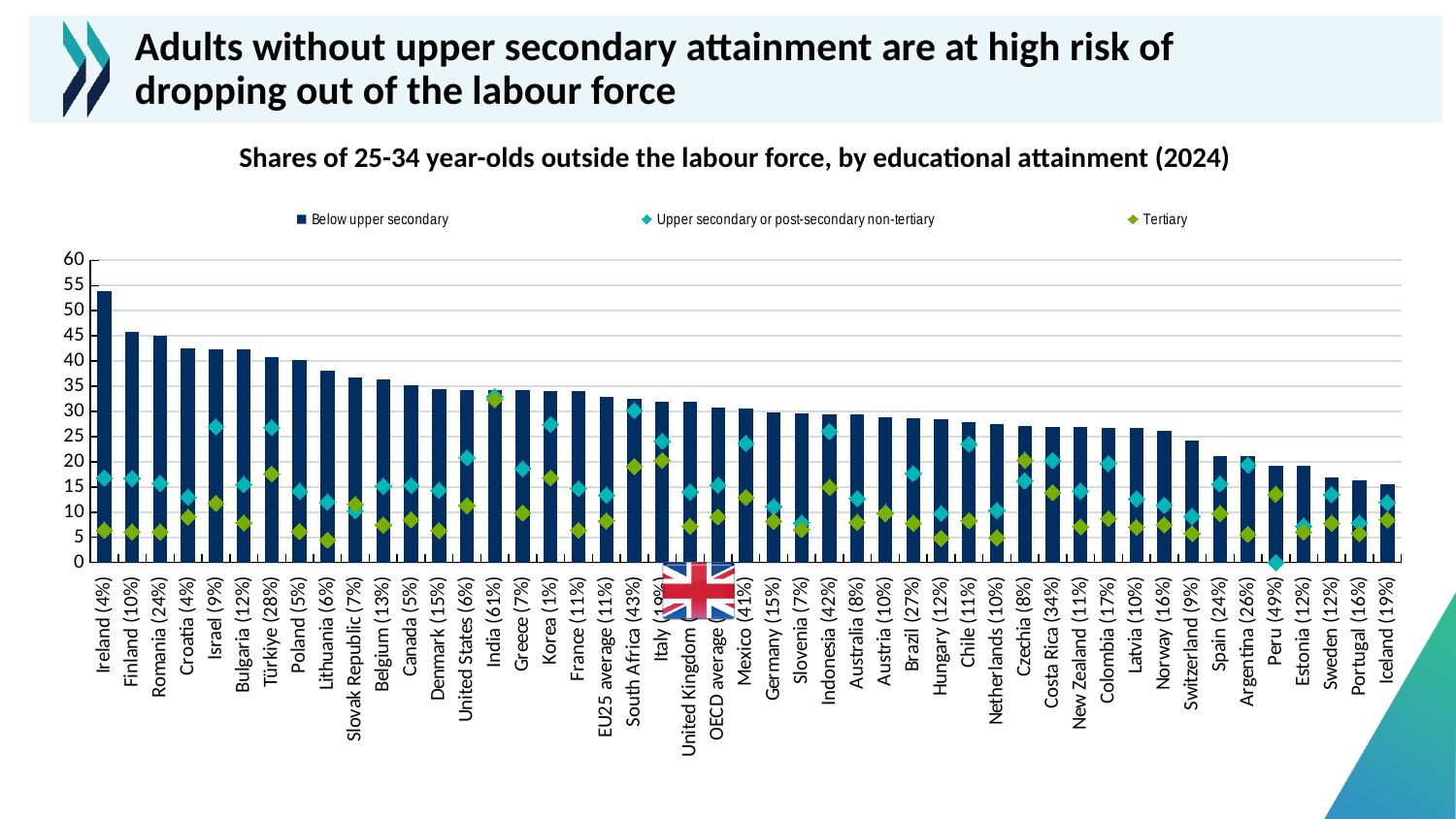
Which has a larger 'Below upper secondary' value, Ireland or Finland? Ireland How many series does the legend list? 3 Is the 'Tertiary' value for Ireland greater or less than 10? less Is the 'Below upper secondary' value for Finland greater or less than 40? greater Is the 'Below upper secondary' value for Iceland greater or less than 20? less Which series is plotted as bars rather than markers? Below upper secondary Do the 'Below upper secondary' bars rise or fall from left to right along the x axis? Fall What is the title of the chart? Shares of 25-34 year-olds outside the labour force, by educational attainment (2024) What kind of chart is shown on the slide? Bar chart with markers Which country has the highest share of 25-34 year-olds with below upper secondary attainment outside the labour force? Ireland (4%)